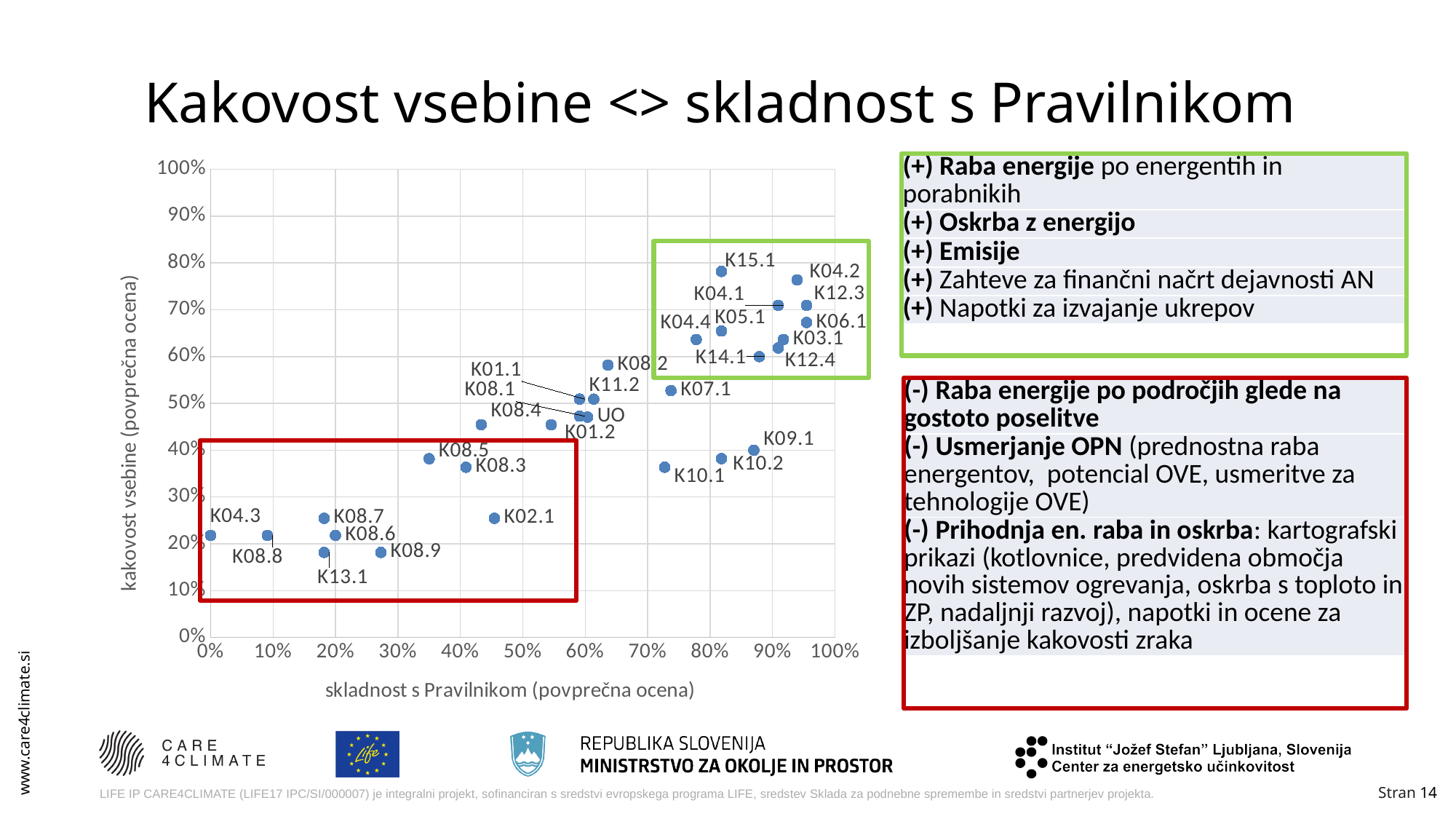
What kind of chart is shown on the slide? scatter chart Which point has the lowest value on the horizontal axis (skladnost s Pravilnikom)? K04.3 Is the vertical-axis value (kakovost vsebine) for K15.1 greater or less than 70%? greater Is the vertical-axis value (kakovost vsebine) for K08.2 greater or less than 50%? greater Is the vertical-axis value (kakovost vsebine) for K13.1 greater or less than 20%? less Which point has a higher horizontal-axis value (skladnost s Pravilnikom), K04.3 or K07.1? K07.1 What is the title of the horizontal axis of the chart? skladnost s Pravilnikom (povprečna ocena) Which point has the highest value on the vertical axis (kakovost vsebine)? K15.1 Which point has a higher vertical-axis value (kakovost vsebine), K15.1 or K02.1? K15.1